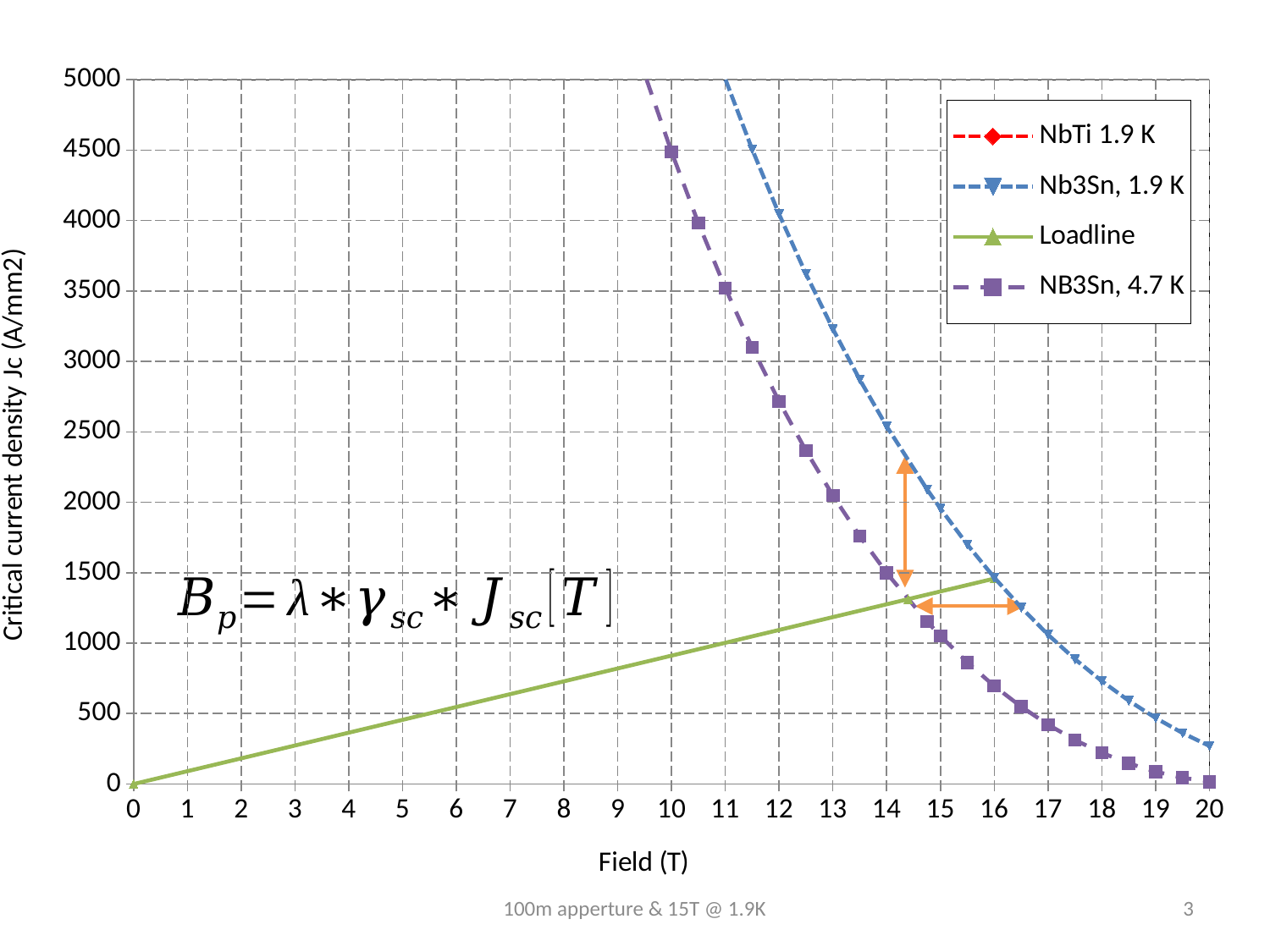
Is the value of the NB3Sn, 4.7 K series at 12 T greater or less than 2500? greater What is the title of the x axis? Field (T) What is the title of the y axis? Critical current density Jc (A/mm2) Is the value of the Nb3Sn, 1.9 K series at 20 T greater or less than 500? less Does the NB3Sn, 4.7 K series rise or fall as the field increases? fall Is the value of the Loadline series at 10 T greater or less than 1000? less At 18 T, which series has the higher value: Nb3Sn, 1.9 K or NB3Sn, 4.7 K? Nb3Sn, 1.9 K At 12 T, which series has the higher value: Nb3Sn, 1.9 K or NB3Sn, 4.7 K? Nb3Sn, 1.9 K What kind of chart is shown on the slide? line chart What is the value of the Loadline series at 0 T? 0 Does the Loadline series rise or fall as the field increases? rise How many series does the legend list? 4